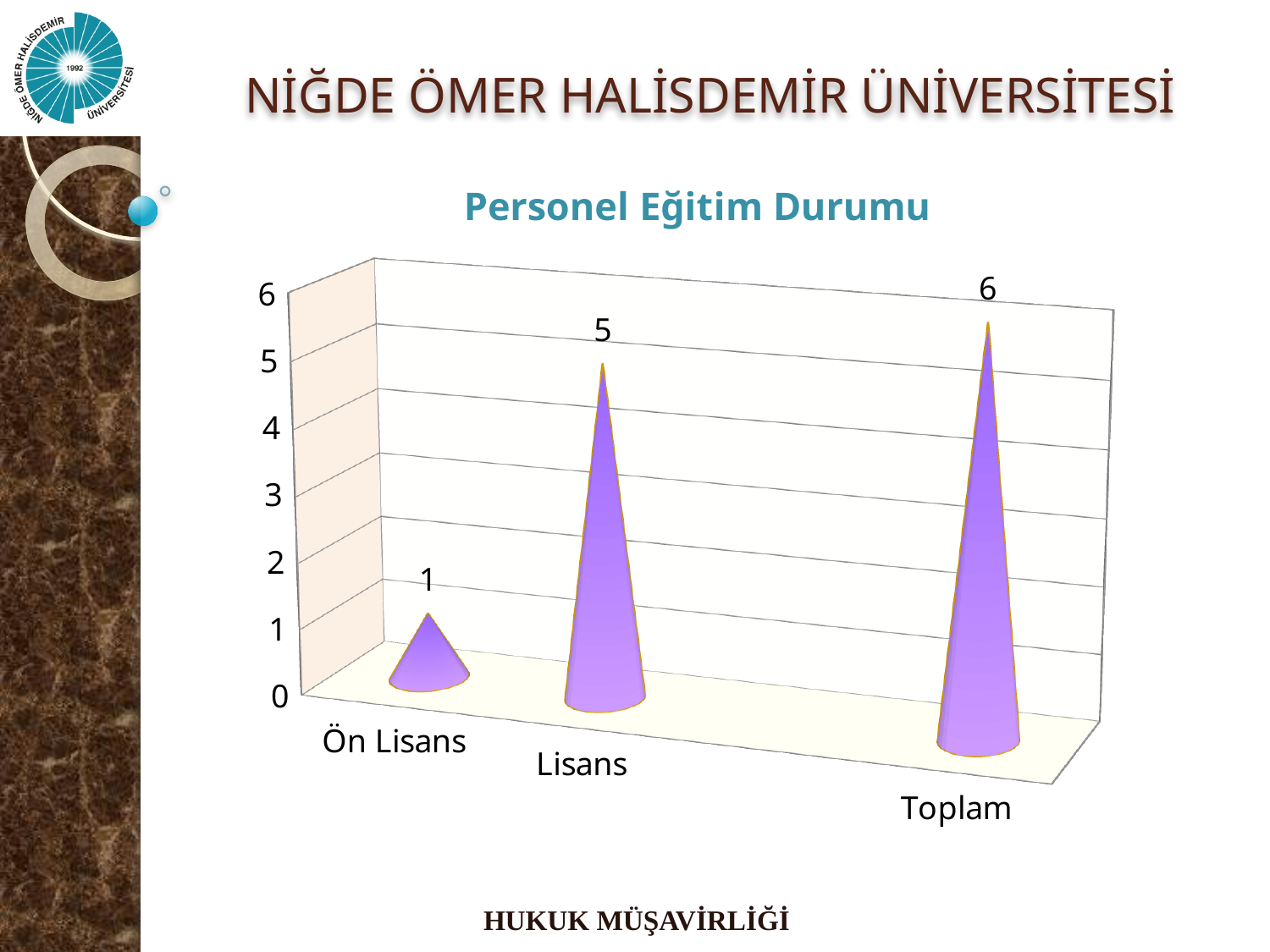
What is the value for Ön Lisans? 1 What is the value for Lisans? 5 What is the difference between the values for Toplam and Lisans? 1 Which category has the lowest value? Ön Lisans What is the difference between the values for Lisans and Ön Lisans? 4 Which is larger, the value for Lisans or the value for Ön Lisans? Lisans Which category has the highest value? Toplam What kind of chart is shown on the slide? bar chart What is the title of the chart? Personel Eğitim Durumu How many categories are shown on the x axis? 3 What is the value for Toplam? 6 Is the value for Lisans greater or less than 3? greater